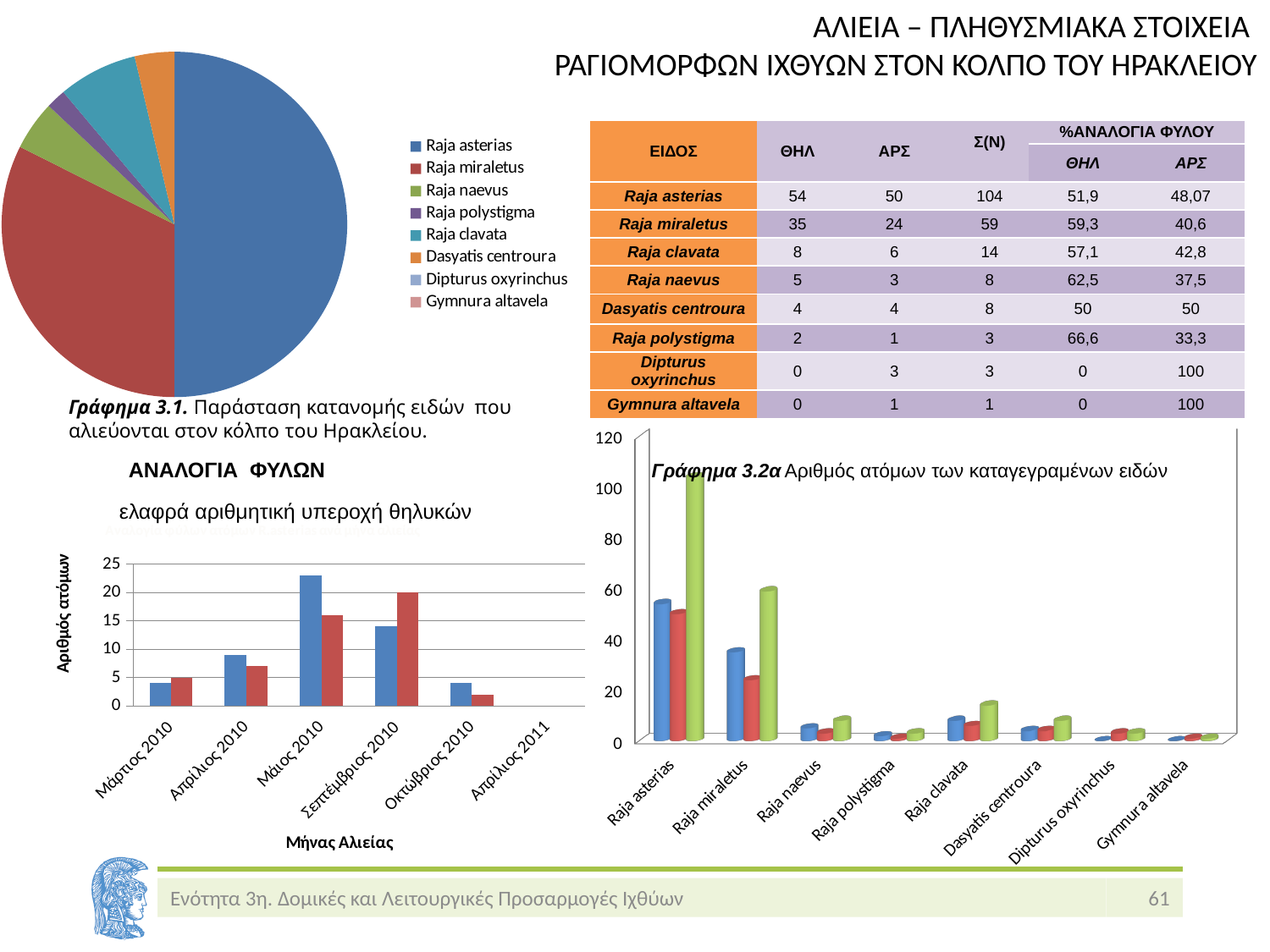
In the bottom-left bar chart (Μήνας Αλιείας), is the blue bar for Μάιος 2010 greater or less than 20? greater In the bottom-left bar chart (Μήνας Αλιείας), is the red bar for Σεπτέμβριος 2010 greater or less than 15? greater In the chart Γράφημα 3.2α, which species has the tallest bars? Raja asterias In the pie chart Γράφημα 3.1, how many entries does the legend list? 8 In the pie chart Γράφημα 3.1, which slice is larger: Raja miraletus or Raja naevus? Raja miraletus What kind of chart is Γράφημα 3.1 at the top left of the slide? pie chart In the bottom-left bar chart (Μήνας Αλιείας), how many month categories are shown on the x axis? 6 In the chart Γράφημα 3.2α, how many species categories are shown on the x axis? 8 In the pie chart Γράφημα 3.1, which species has the largest slice? Raja asterias What kind of chart is the bottom-left chart with the x axis labelled Μήνας Αλιείας? bar chart In the bottom-left bar chart (Μήνας Αλιείας), which month has the tallest blue bar? Μάιος 2010 In the chart Γράφημα 3.2α, is the green bar for Raja asterias greater or less than 100? greater